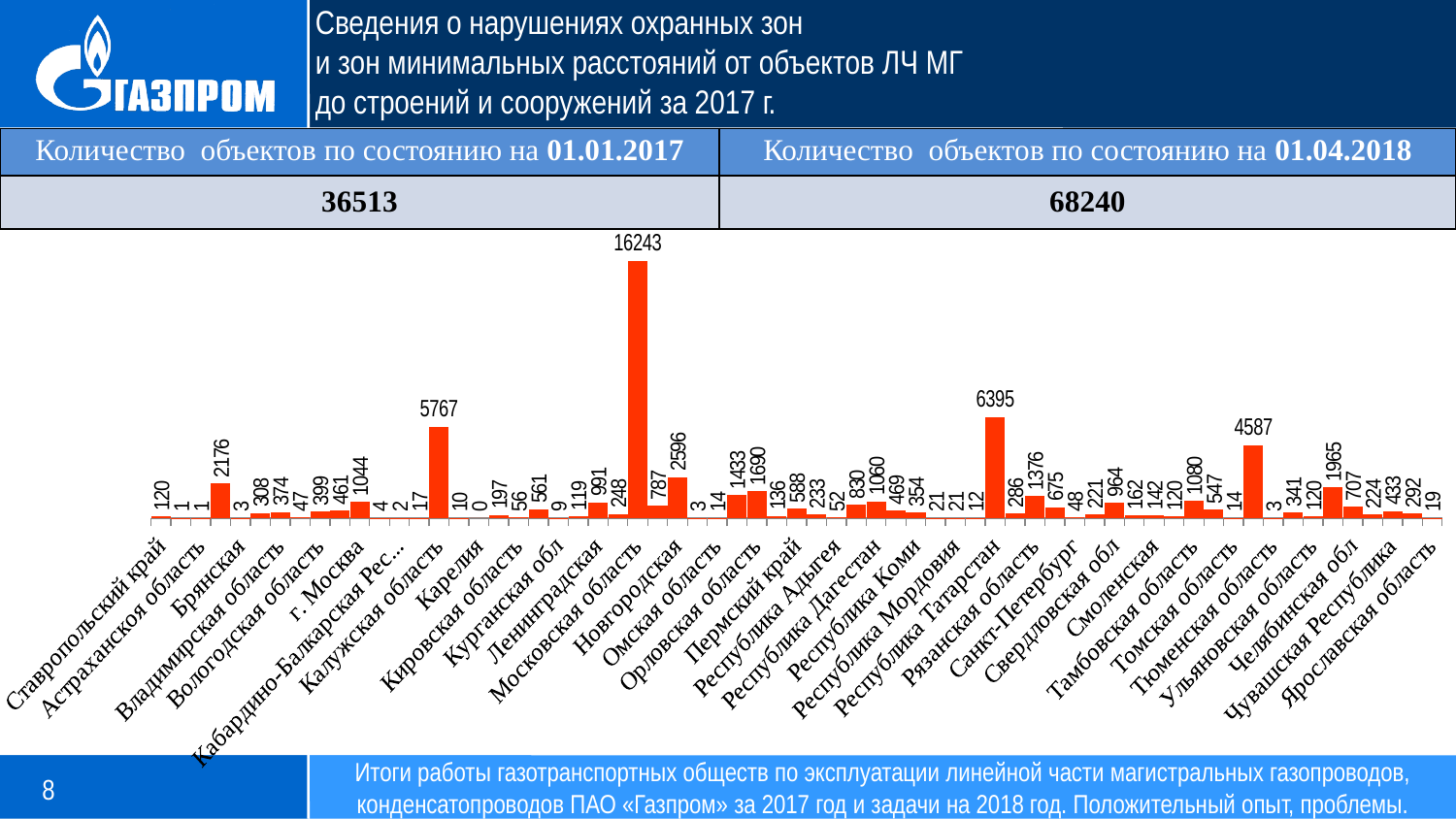
What is the value shown for Республика Татарстан? 6395 Which is larger, the value for Калужская область or the value for Тюменская область? Калужская область What is the value shown for Новгородская? 2596 What is the difference between the values for Московская область and Республика Татарстан? 9848 Which region has the highest bar in the chart? Московская область Which is larger, the value for Республика Татарстан or the value for Тюменская область? Республика Татарстан What is the value shown for Калужская область? 5767 What is the value shown for Московская область? 16243 What colour are the bars in the chart? red-orange What is the difference between the values for Республика Татарстан and Калужская область? 628 What type of chart is shown on the slide? bar chart